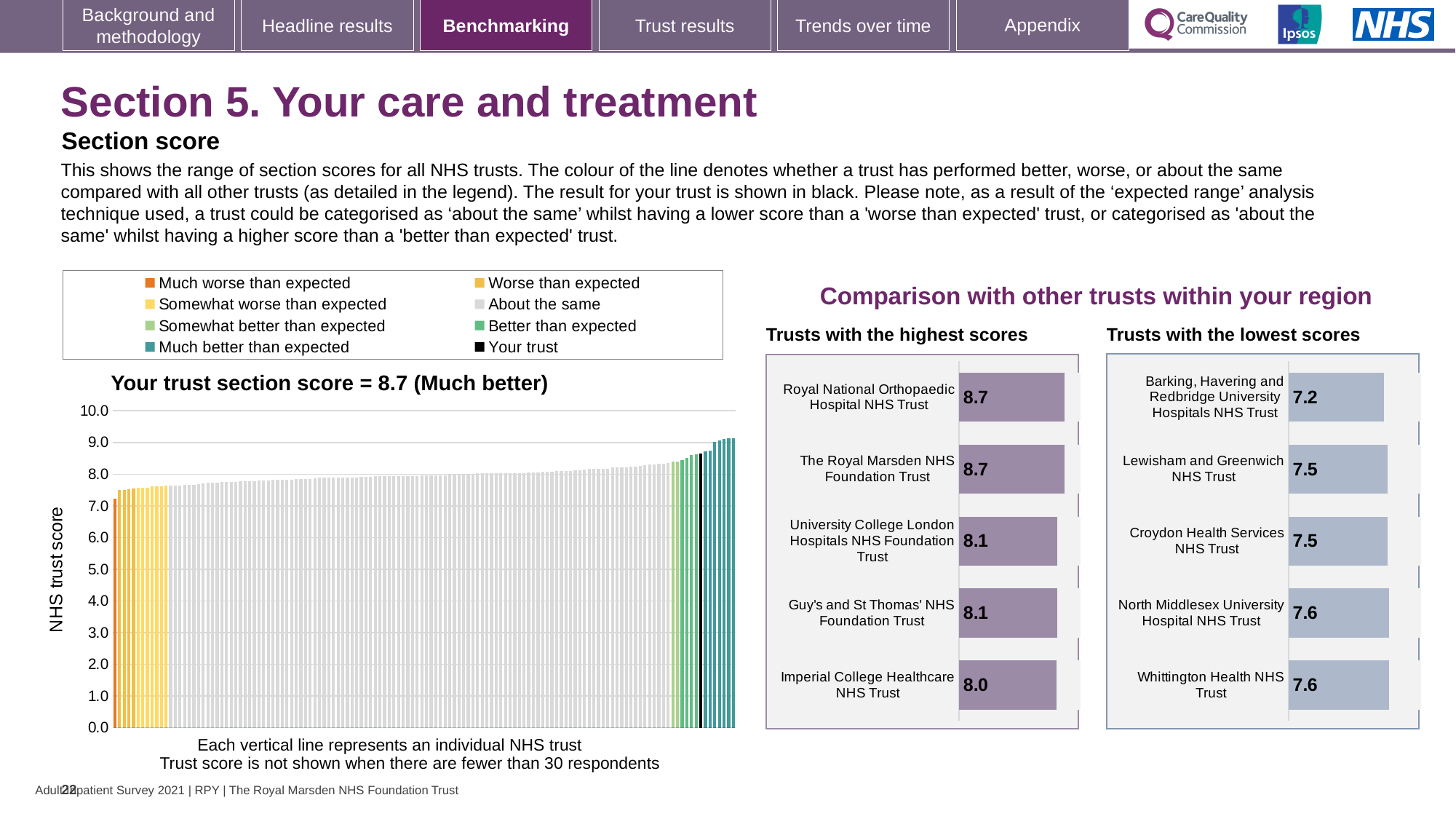
How many trusts are shown in the 'Trusts with the highest scores' chart? 5 How many entries does the legend above the 'Your trust section score' chart list? 8 In the 'Trusts with the highest scores' chart, which trust has the lowest score? Imperial College Healthcare NHS Trust In the 'Trusts with the lowest scores' chart, what is the score for Lewisham and Greenwich NHS Trust? 7.5 In the 'Trusts with the lowest scores' chart, which trust has the lowest score? Barking, Havering and Redbridge University Hospitals NHS Trust In the 'Trusts with the highest scores' chart, what is the difference between the score for The Royal Marsden NHS Foundation Trust and the score for Imperial College Healthcare NHS Trust? 0.7 In the 'Your trust section score' chart on the left, do the bar values rise or fall from left to right along the x axis? rise In the 'Trusts with the highest scores' chart, what is the score for Imperial College Healthcare NHS Trust? 8.0 In the 'Trusts with the lowest scores' chart, which has the larger score: Barking, Havering and Redbridge University Hospitals NHS Trust or North Middlesex University Hospital NHS Trust? North Middlesex University Hospital NHS Trust In the 'Trusts with the highest scores' chart, what is the score for University College London Hospitals NHS Foundation Trust? 8.1 In the 'Your trust section score' chart on the left, is the value of the leftmost (orange) bar greater or less than 8.0? less In the 'Trusts with the lowest scores' chart, what is the difference between the score for Whittington Health NHS Trust and the score for Barking, Havering and Redbridge University Hospitals NHS Trust? 0.4